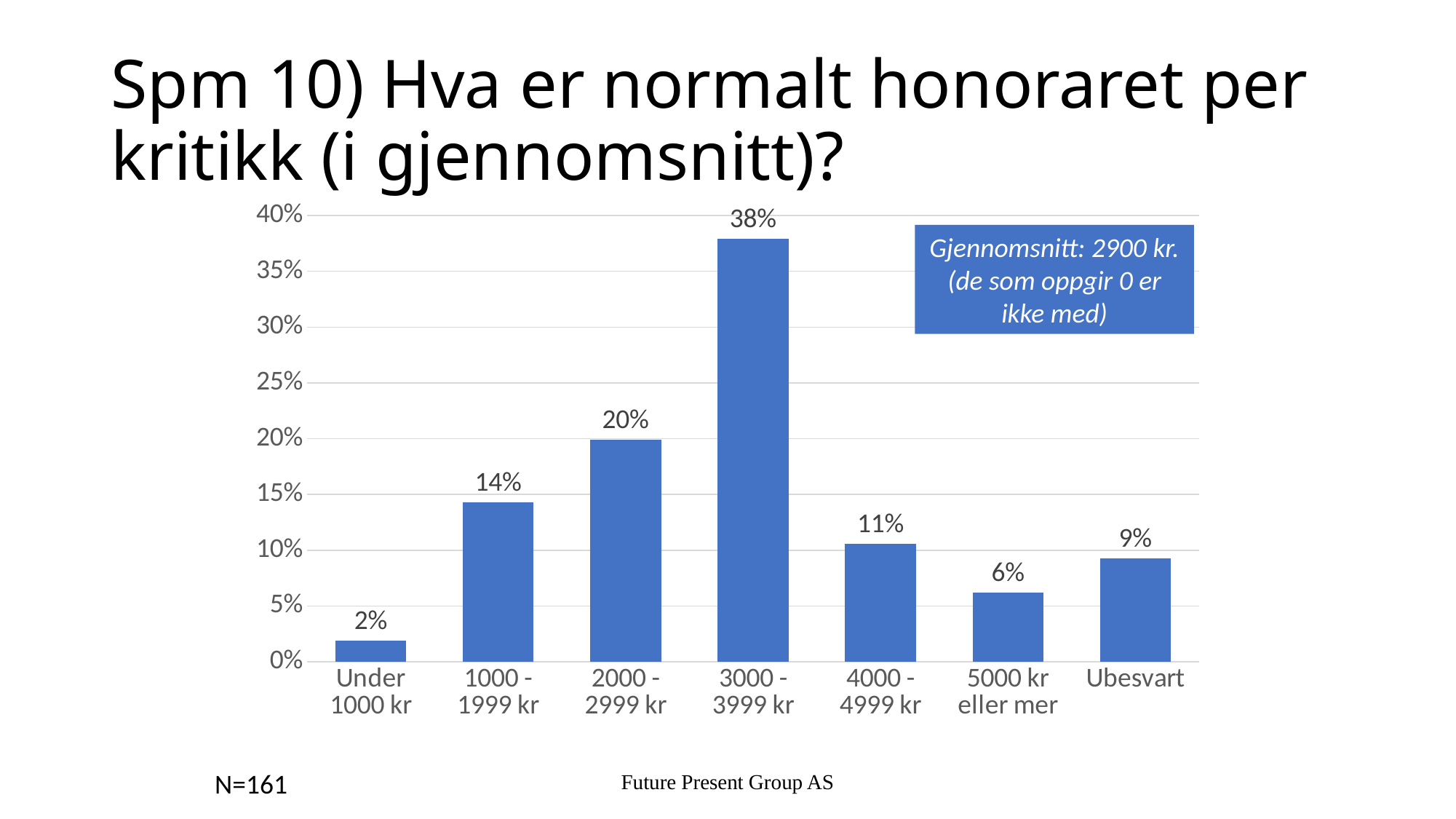
What kind of chart is shown on the slide? bar chart What is the value for the Under 1000 kr category? 2% Which category has the highest value? 3000 - 3999 kr What is the value for the Ubesvart category? 9% What is the value for the 3000 - 3999 kr category? 38% Which category has the lowest value? Under 1000 kr Which is larger, the value for 4000 - 4999 kr or the value for 5000 kr eller mer? 4000 - 4999 kr How many categories are shown on the x axis? 7 What is the difference between the values for 2000 - 2999 kr and 1000 - 1999 kr? 6% What is the sample size (N) shown on the slide? N=161 Is the value for 2000 - 2999 kr greater or less than 25%? less What is the average (gjennomsnitt) stated in the text box on the chart? 2900 kr.